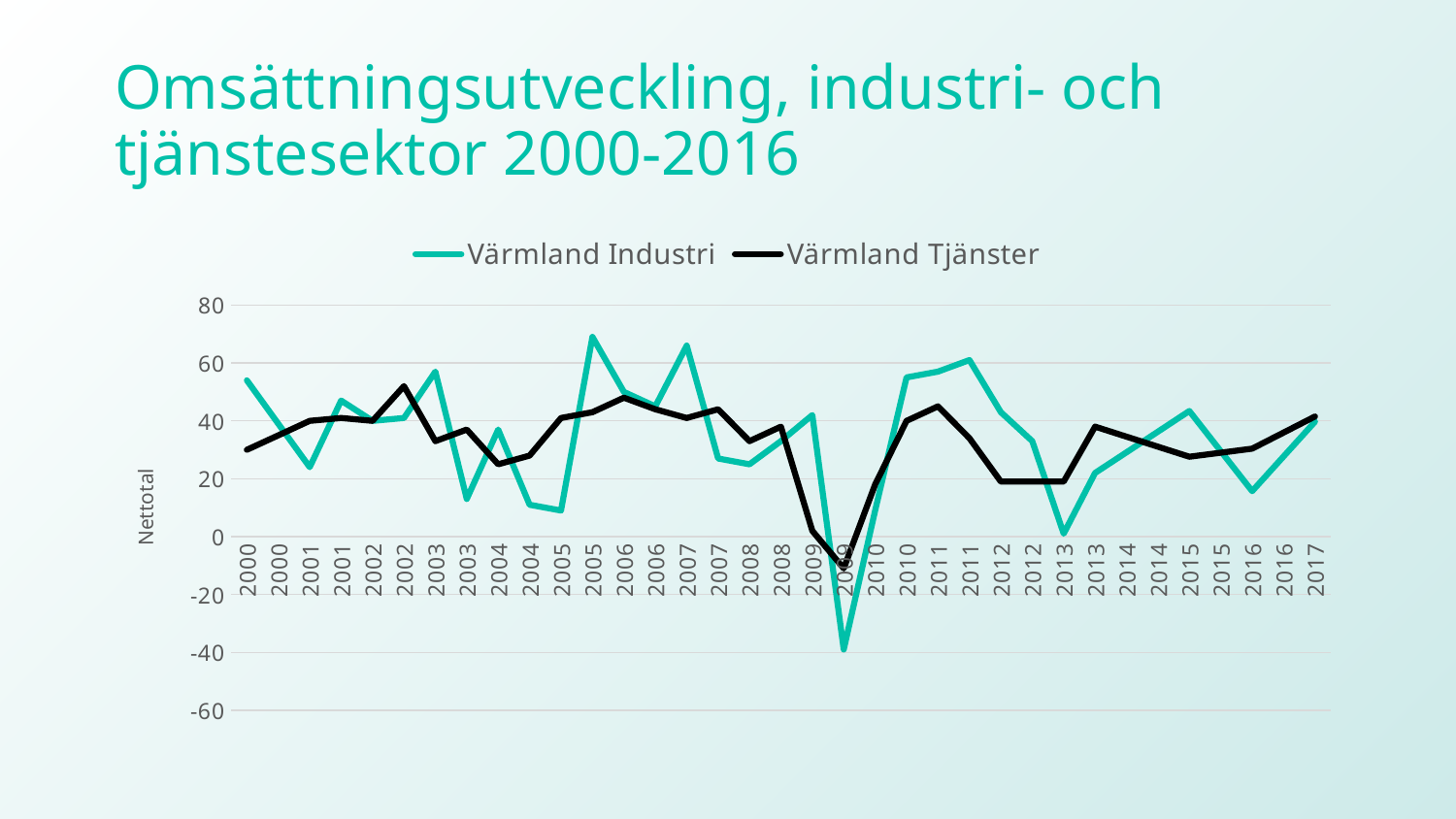
What colour is the line for Värmland Tjänster? black Which series reaches the highest value on the chart? Värmland Industri What is the last year label shown on the x axis? 2017 Is the highest value of Värmland Tjänster greater or less than 60? less What is the label on the vertical axis? Nettotal Which series reaches the lowest value on the chart? Värmland Industri Is the lowest value of Värmland Industri greater or less than -20? less Is the value for Värmland Tjänster at 2017 greater or less than 20? greater Between 2008 and 2009, do the values for Värmland Tjänster rise or fall? fall How many series does the legend list? 2 What kind of chart is shown on the slide? line chart